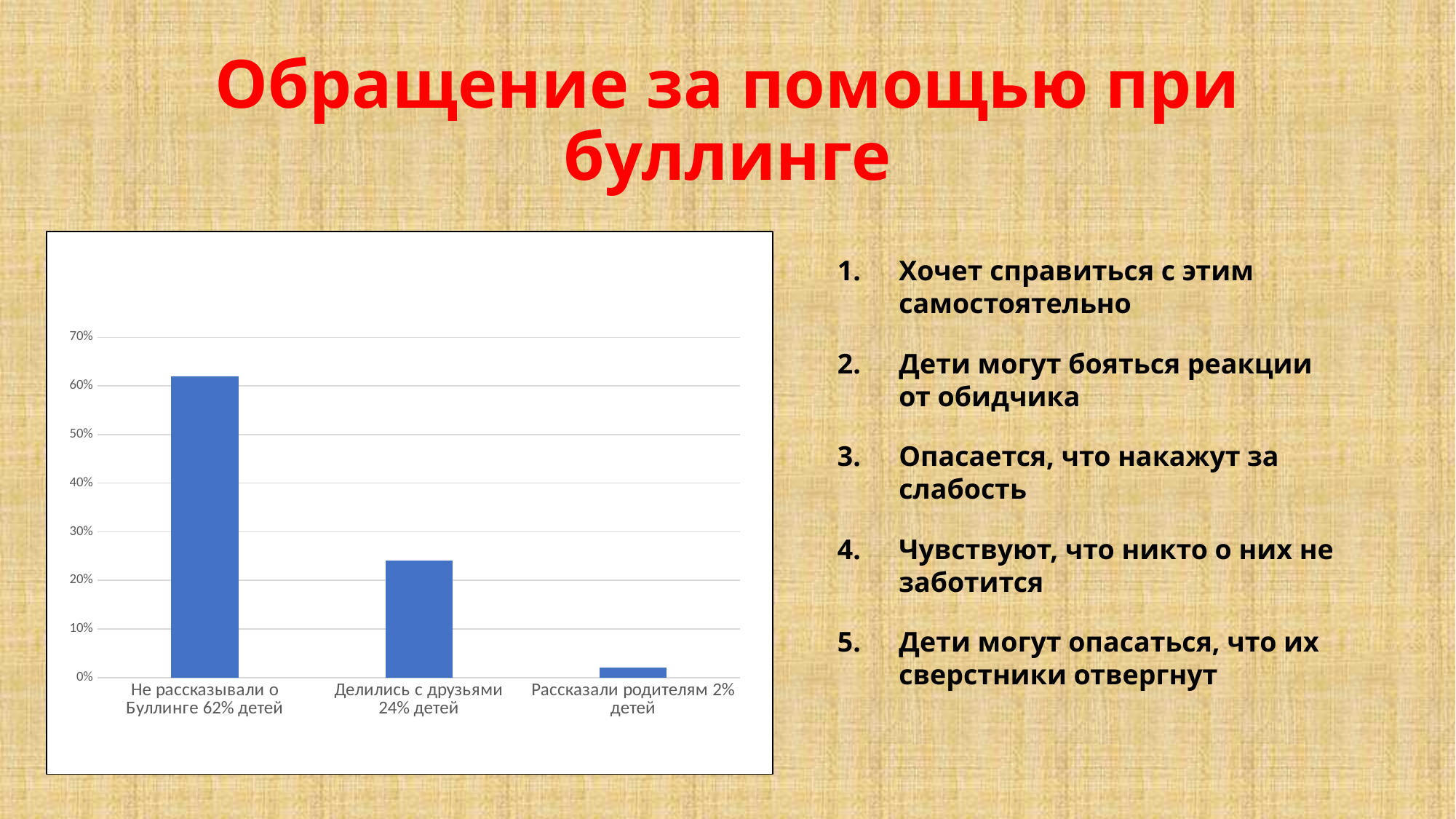
What kind of chart is shown on the slide? bar chart What is the difference between the share of children who shared with friends and the share who told their parents? 22% Is the value for "Не рассказывали о Буллинге" greater or less than 50%? greater What percentage of children shared with friends ("Делились с друзьями")? 24% What percentage of children did not tell anyone about bullying ("Не рассказывали о Буллинге")? 62% Which category has the highest value? Не рассказывали о Буллинге How many bars (categories) does the chart show? 3 Which is larger: the value for "Делились с друзьями" or the value for "Рассказали родителям"? Делились с друзьями Do the bar values rise or fall from left to right along the x axis? fall What is the difference between the share of children who did not tell anyone and the share who shared with friends? 38% What percentage of children told their parents ("Рассказали родителям")? 2% Which category has the lowest value? Рассказали родителям